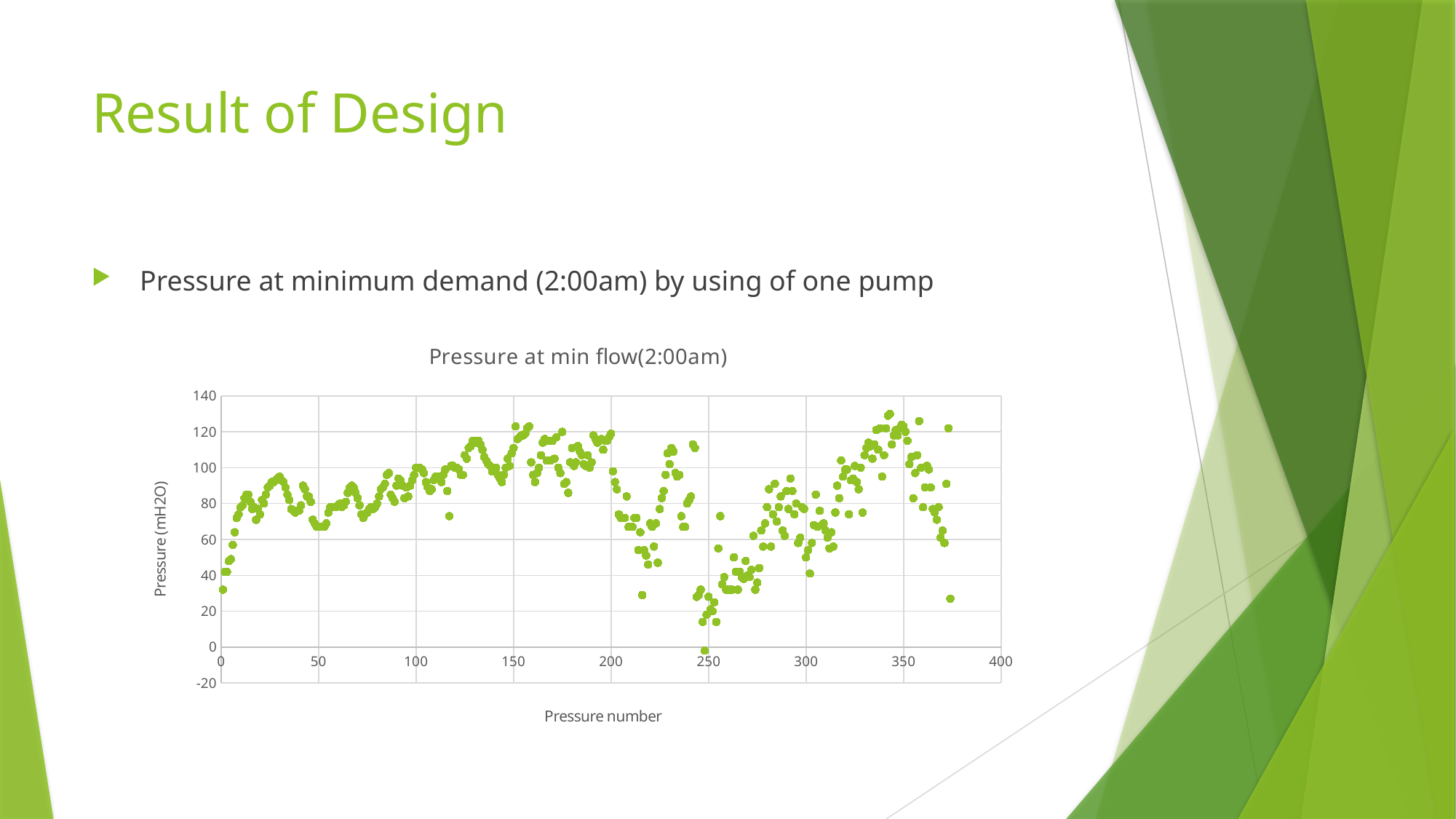
Which is higher: the highest point near pressure number 340 or the lowest point near pressure number 250? the highest point near pressure number 340 Is the lowest plotted pressure value on the chart greater or less than 20? less What kind of chart is shown on the slide? scatter chart Is the value of the lowest point near pressure number 250 greater or less than 20? less What is the title of the chart? Pressure at min flow(2:00am) Is the highest plotted pressure value on the chart greater or less than 120? greater What is the label of the vertical axis of the chart? Pressure (mH2O) Do the plotted values rise or fall between pressure number 0 and pressure number 30? rise